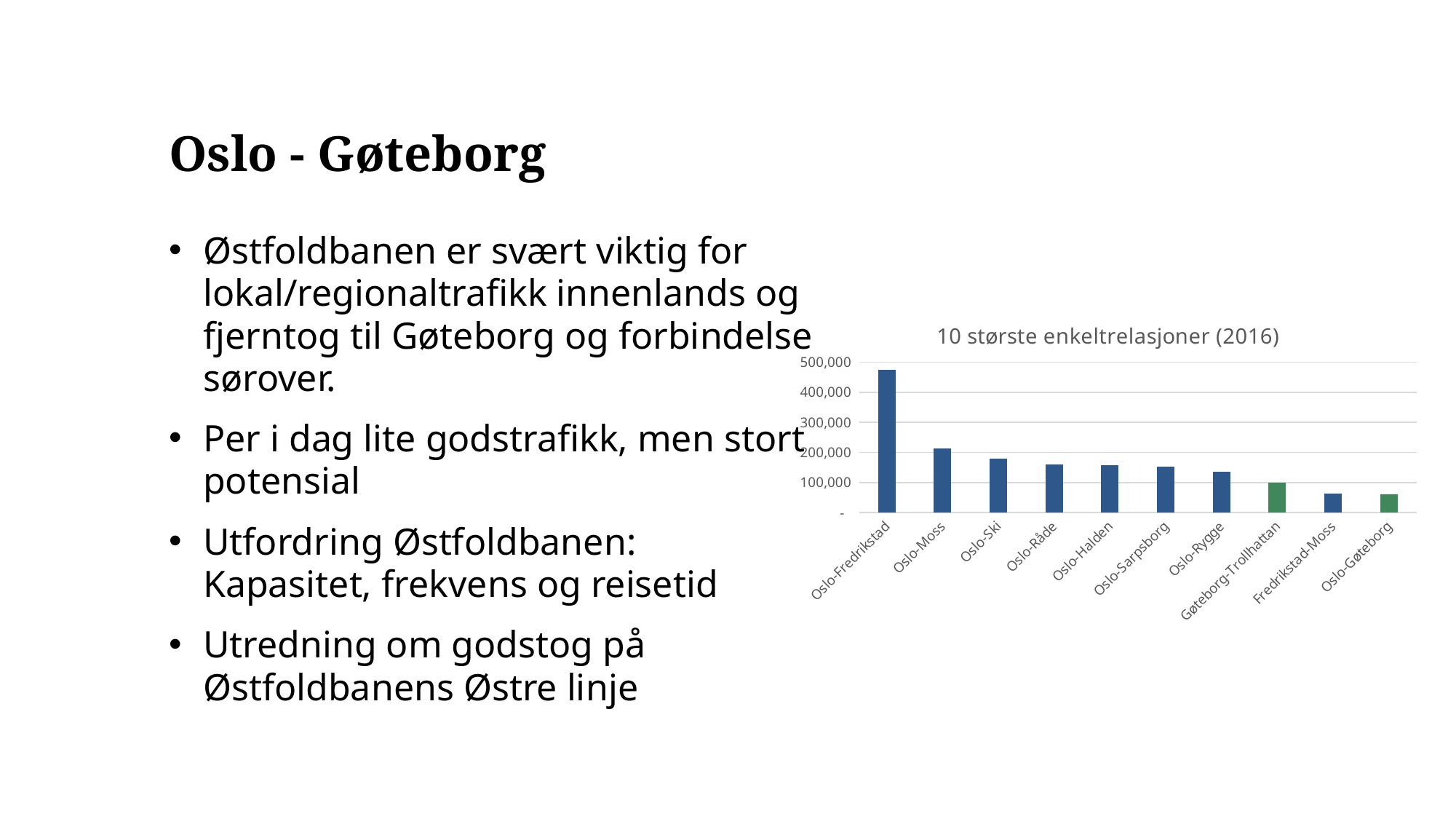
Is the value for Oslo-Ski greater or less than 200,000? less How many categories are plotted in the chart? 10 Which is larger, the value for Oslo-Moss or the value for Oslo-Ski? Oslo-Moss Is the value for Oslo-Gøteborg greater or less than 100,000? less What is the title of the chart? 10 største enkeltrelasjoner (2016) What kind of chart is shown on the slide? Bar chart Which category has the highest value in the chart? Oslo-Fredrikstad Do the values rise or fall from left to right along the x axis? fall What colour is the bar for Oslo-Gøteborg? Green Is the value for Fredrikstad-Moss greater or less than 100,000? less